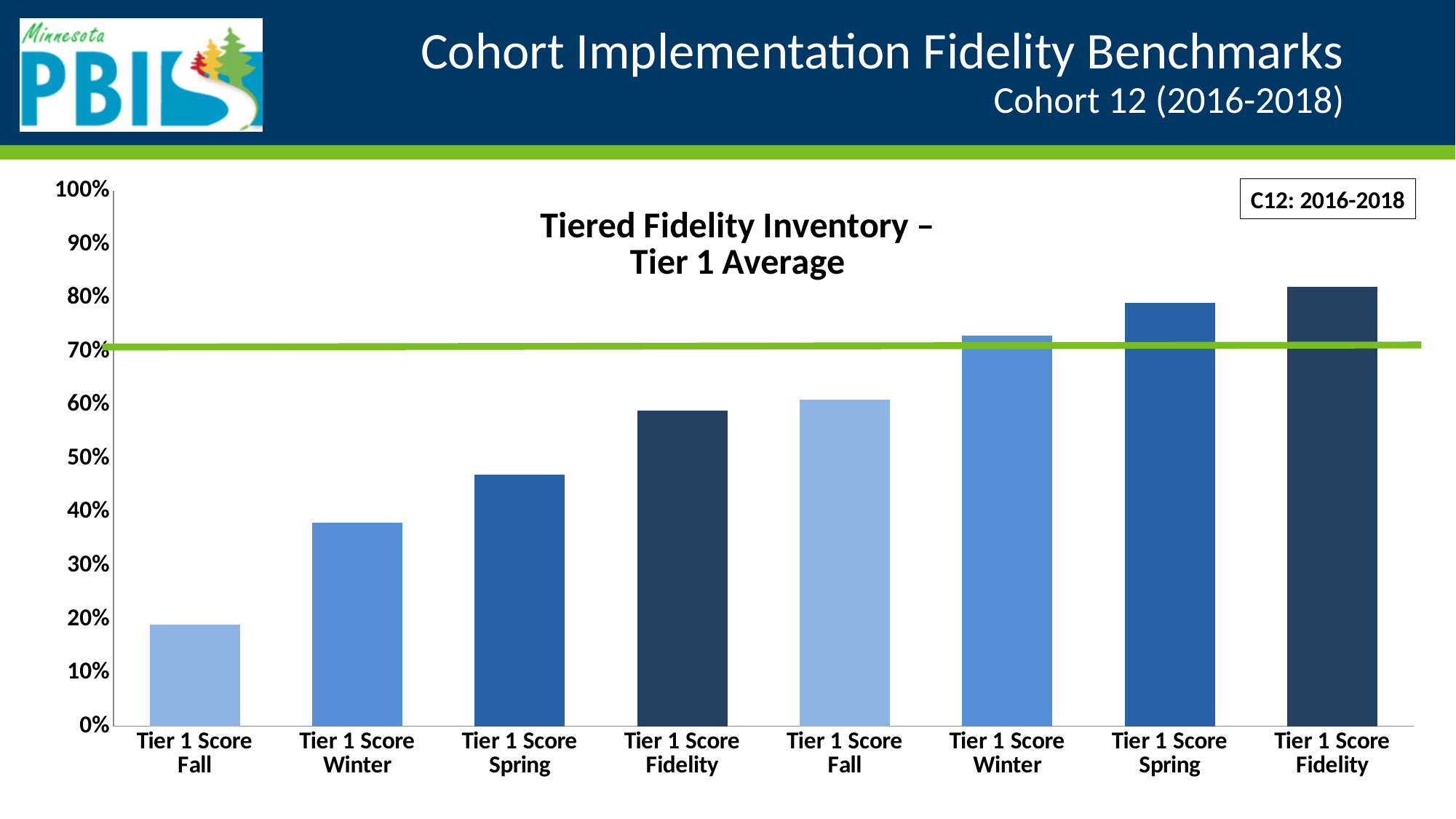
Is the value for the first Tier 1 Score Winter bar (second from left) greater or less than 30%? greater Which bar has the highest value in the chart? Tier 1 Score Fidelity (the rightmost bar) What is the title of the chart? Tiered Fidelity Inventory – Tier 1 Average How many bars extend above the green horizontal line at 70%? 3 Is the value for the second Tier 1 Score Spring bar (seventh from left) greater or less than 70%? greater Which is larger, the first Tier 1 Score Winter bar or the first Tier 1 Score Spring bar? Tier 1 Score Spring How many bars are plotted in the chart? 8 Do the bar values generally rise or fall from left to right across the chart? rise Is the value for the leftmost Tier 1 Score Fall bar greater or less than 30%? less Which bar has the lowest value in the chart? Tier 1 Score Fall (the leftmost bar) What kind of chart is shown on the slide? bar chart